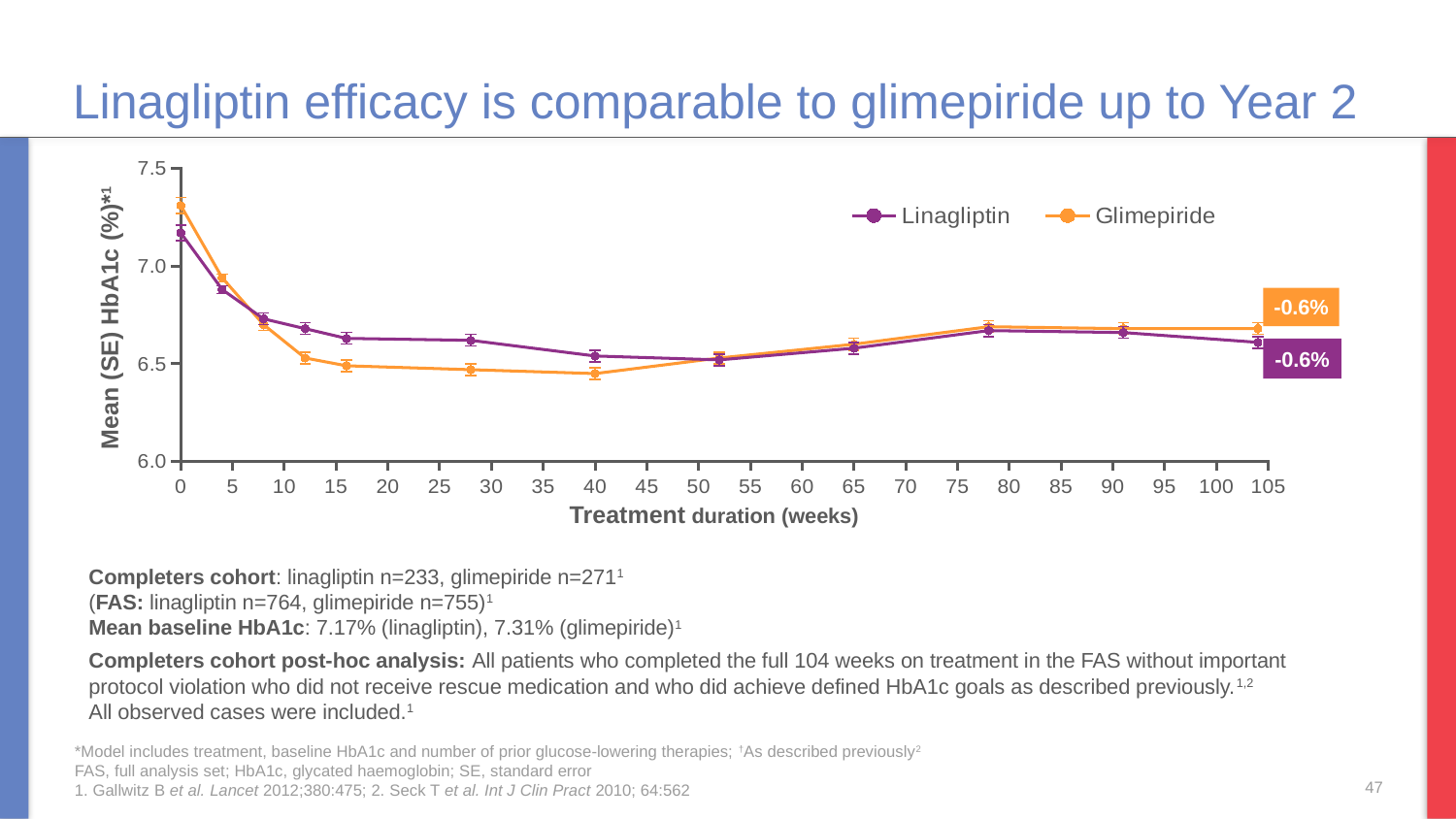
Is the Glimepiride value at week 0 greater or less than 7.0? greater Between week 0 and week 16, does the Glimepiride line rise or fall? fall At week 16, which series has the higher HbA1c value, Linagliptin or Glimepiride? Linagliptin What change in HbA1c is labelled at the end of the Glimepiride line? -0.6% How many series does the chart legend list? 2 What is the title of the x axis of the chart? Treatment duration (weeks) What type of chart is shown on the slide? line chart What change in HbA1c is labelled at the end of the Linagliptin line? -0.6% Is the Linagliptin value at week 4 greater or less than 7.0? less What are the two series named in the chart legend? Linagliptin and Glimepiride At week 0, which series has the higher HbA1c value, Linagliptin or Glimepiride? Glimepiride Is the Linagliptin value at week 40 greater or less than 7.0? less